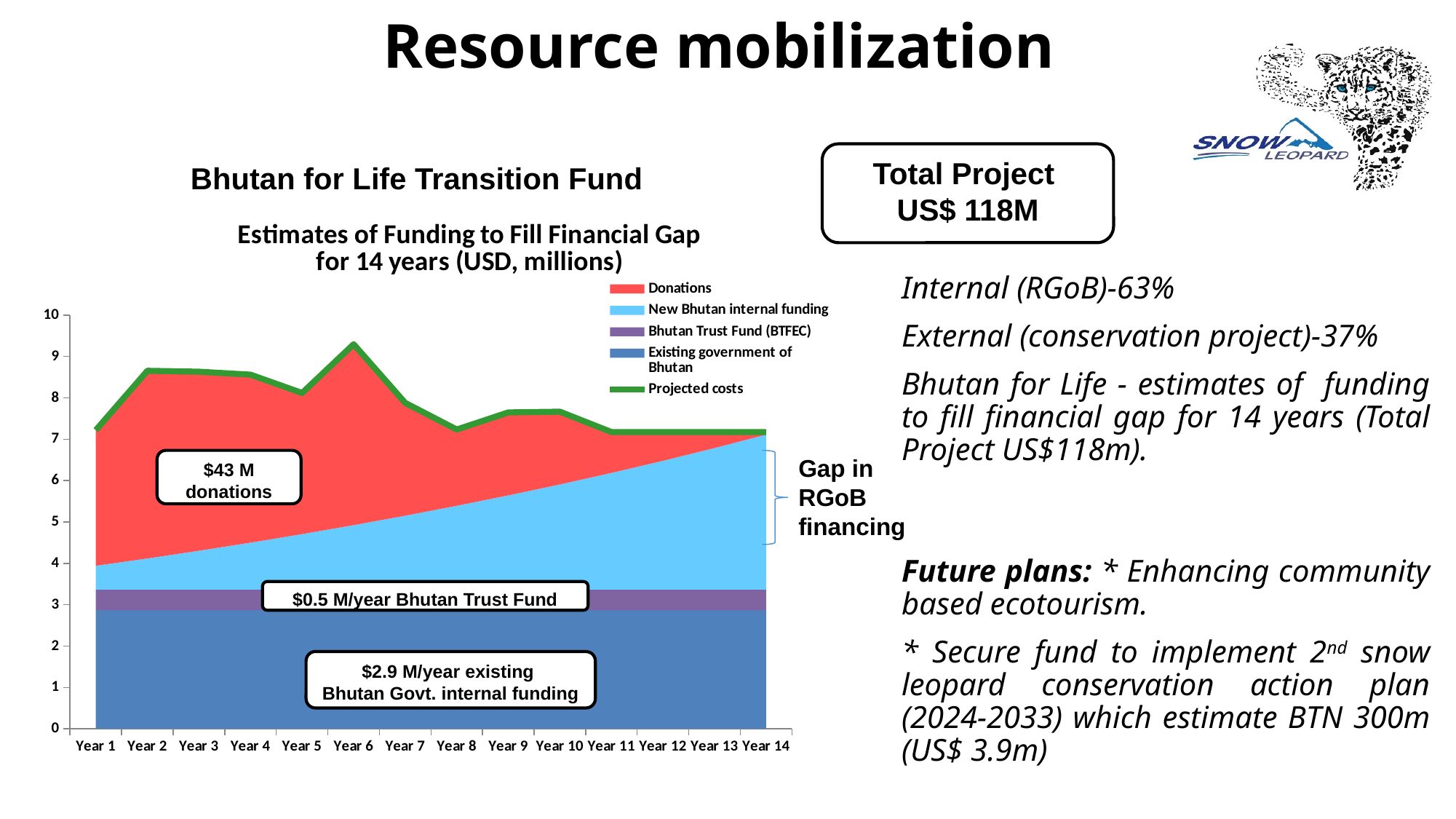
Are the projected costs in Year 14 greater or less than 8? less According to the label on the chart, how much per year is existing Bhutan Govt. internal funding? $2.9 M/year How many years (categories) are shown along the x axis of the chart? 14 How many entries does the chart's legend list? 5 Which year has higher projected costs, Year 6 or Year 8? Year 6 According to the label on the chart, how much per year comes from the Bhutan Trust Fund? $0.5 M/year Do the projected costs rise or fall from Year 6 to Year 8? fall Which colour represents Donations in the chart's legend? red In which year do the projected costs reach their highest point? Year 6 Are the projected costs in Year 6 greater or less than 9? greater According to the label on the chart, what is the total amount of donations? $43 M What kind of chart is shown on the slide? area chart